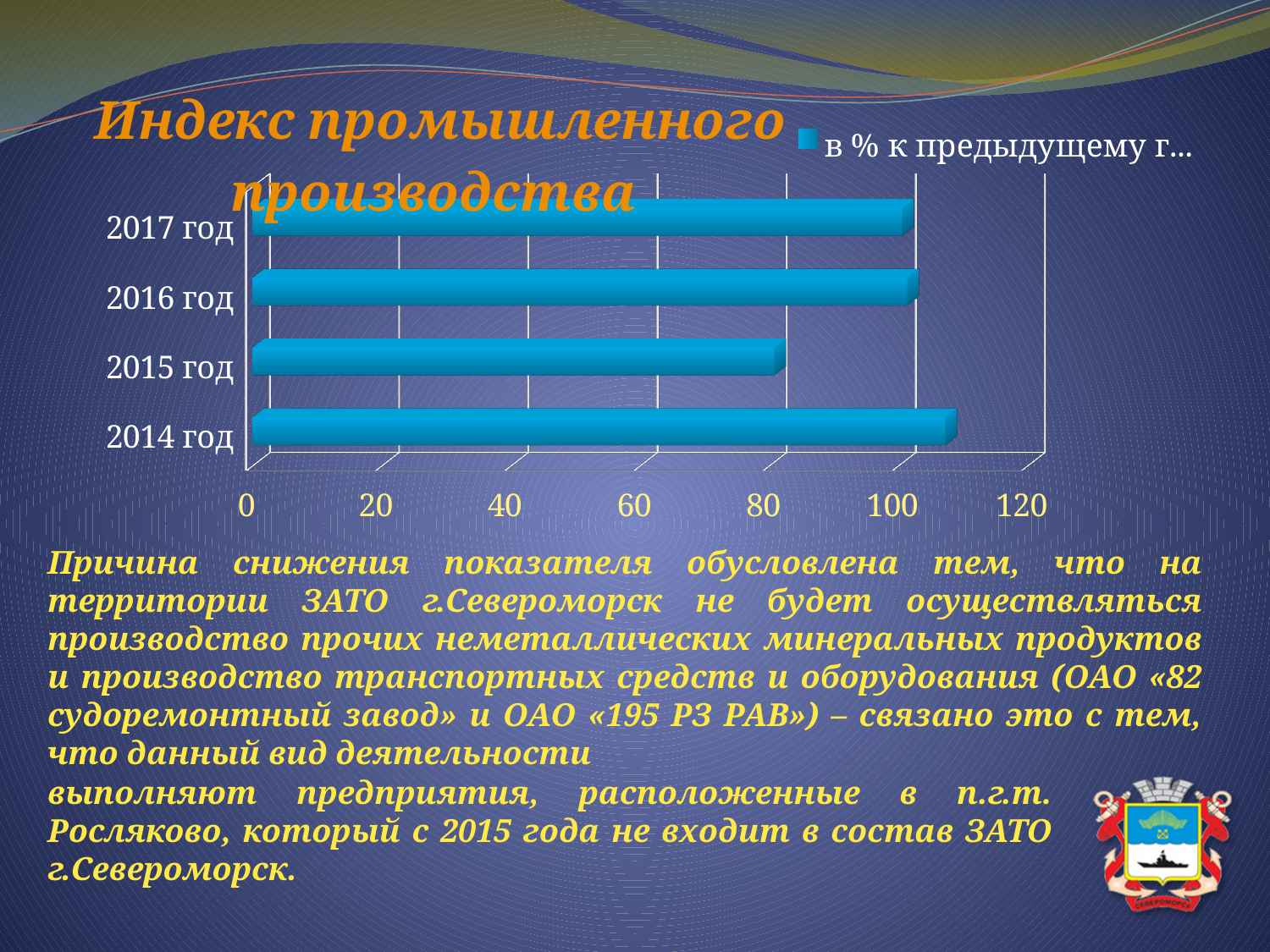
Is the value for 2015 год greater or less than 100? less What kind of chart is shown on the slide? bar chart Which is larger, the value for 2015 год or the value for 2016 год? 2016 год Is the value for 2015 год greater or less than 60? greater Which is larger, the value for 2014 год or the value for 2015 год? 2014 год Is the value for 2017 год greater or less than 80? greater Which year has the highest value in the chart? 2014 год What is the title of the chart? Индекс промышленного производства How many series does the chart legend list? 1 How many years (categories) are shown in the chart? 4 Which year has the lowest value in the chart? 2015 год